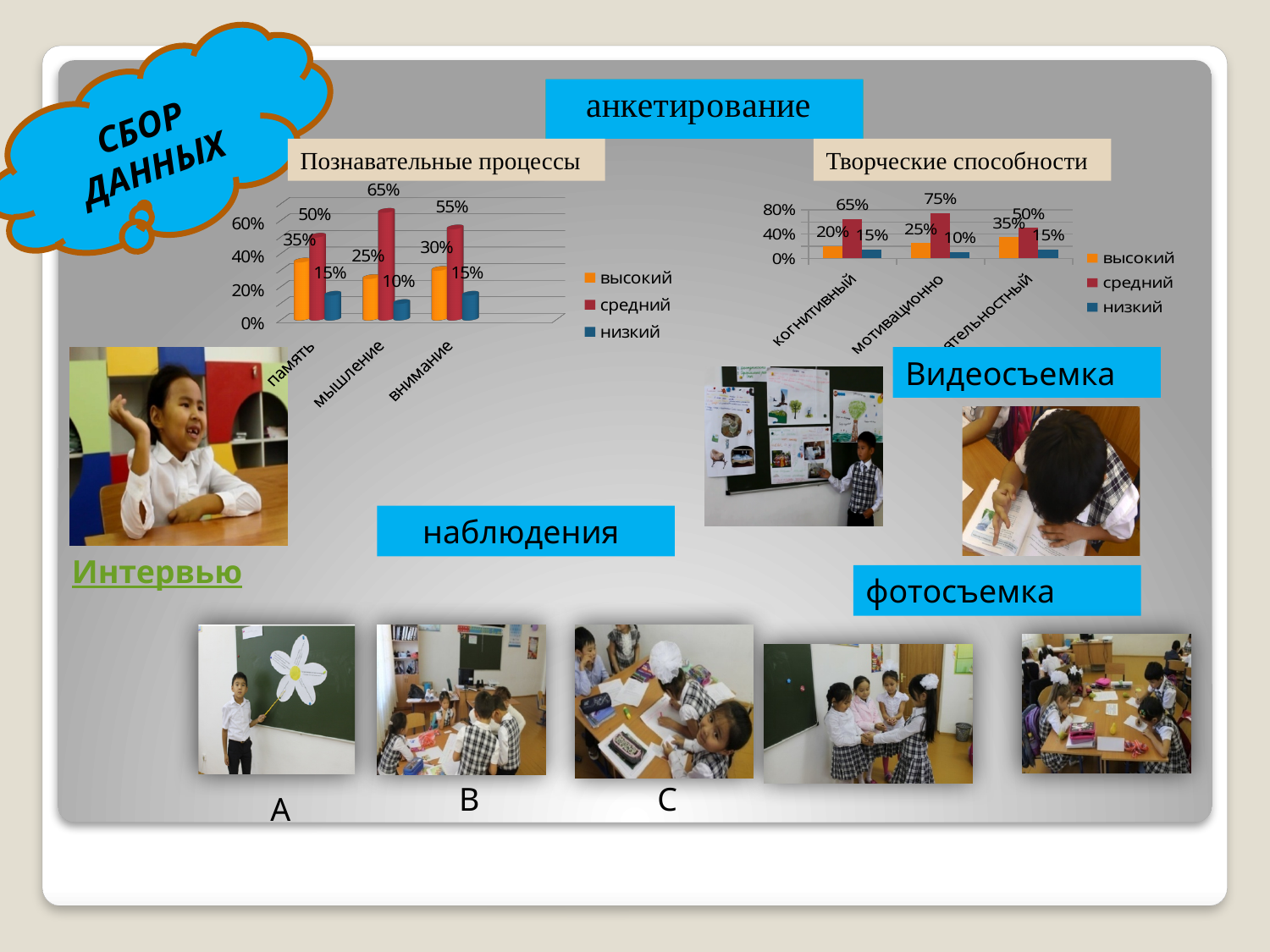
In the 'Познавательные процессы' chart, which category has the highest 'средний' value? мышление In the 'Творческие способности' chart, what is the difference between the 'средний' values for 'мотивационно' and 'когнитивный'? 10% In the 'Познавательные процессы' chart, how many series does the legend list? 3 In the 'Познавательные процессы' chart, what is the value of 'средний' for 'мышление'? 65% In the 'Творческие способности' chart, what is the value of 'средний' for 'мотивационно'? 75% What kind of chart is 'Творческие способности'? bar chart In the 'Познавательные процессы' chart, which category has the lowest 'низкий' value? мышление In the 'Творческие способности' chart, what is the value of 'высокий' for 'когнитивный'? 20% In the 'Познавательные процессы' chart, what is the difference between the 'средний' and 'высокий' values for 'внимание'? 25% In the 'Познавательные процессы' chart, what is the value of 'высокий' for 'память'? 35% In the 'Познавательные процессы' chart, how many categories are shown on the x axis? 3 In the 'Творческие способности' chart, which is larger for 'когнитивный': 'высокий' or 'низкий'? высокий